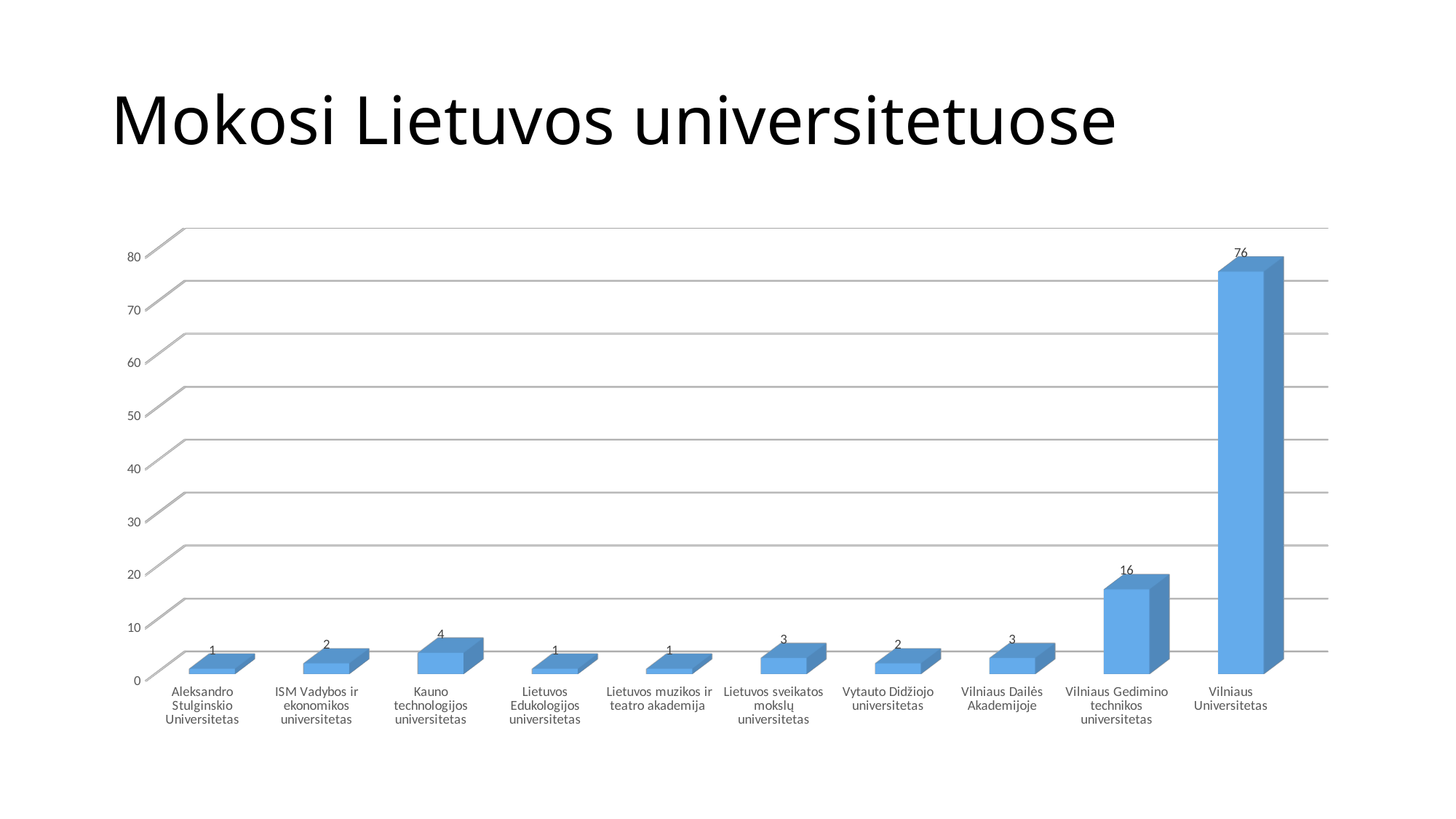
How many universities are shown on the chart? 10 What is the value for Vilniaus Gedimino technikos universitetas? 16 What is the value for Kauno technologijos universitetas? 4 What is the title of the slide? Mokosi Lietuvos universitetuose What is the difference between the values for Vilniaus Dailės Akademijoje and Lietuvos Edukologijos universitetas? 2 Is the value for Vilniaus Universitetas greater or less than 70? greater Which is larger, the value for Kauno technologijos universitetas or the value for ISM Vadybos ir ekonomikos universitetas? Kauno technologijos universitetas What is the value for Vilniaus Universitetas? 76 What kind of chart is shown on the slide? bar chart Which university has the highest value? Vilniaus Universitetas What is the difference between the values for Vilniaus Universitetas and Vilniaus Gedimino technikos universitetas? 60 What is the value for Lietuvos sveikatos mokslų universitetas? 3